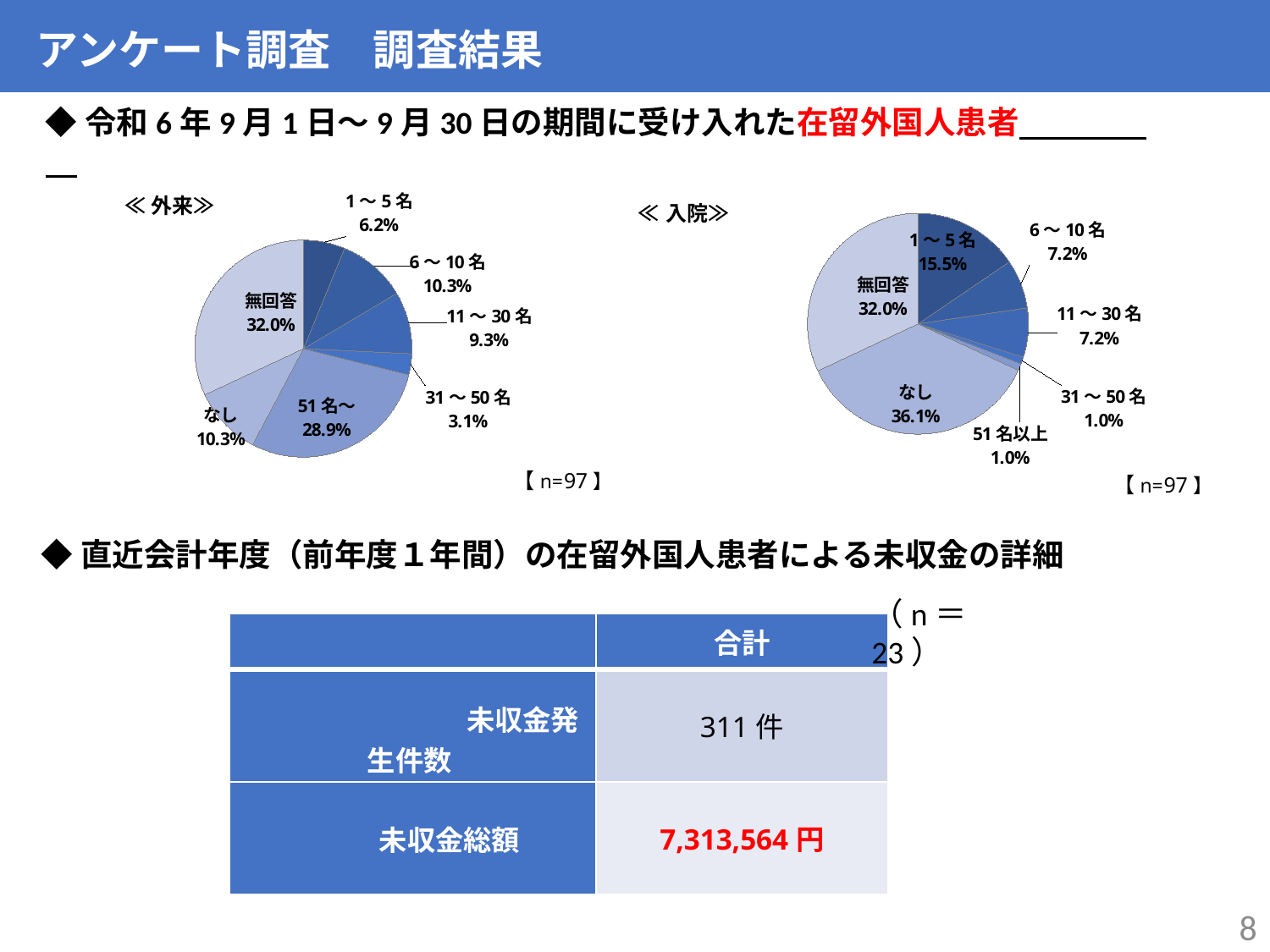
What kind of chart is the ≪外来≫ chart? pie chart In the ≪外来≫ chart, which category has the smallest share? 31～50名 In the ≪外来≫ chart, which category has the largest share? 無回答 In the ≪入院≫ chart, what is the difference between the shares for なし and 無回答? 4.1% In the ≪外来≫ chart, what is the difference between the shares for 6～10名 and 1～5名? 4.1% In the ≪入院≫ chart, which is larger, the share for 1～5名 or the share for 6～10名? 1～5名 In the ≪入院≫ chart, what is the share for 1～5名? 15.5% In the ≪外来≫ chart, what is the share for 無回答? 32.0% In the ≪入院≫ chart, which category has the largest share? なし In the ≪入院≫ chart, what is the share for なし? 36.1% How many categories are shown in the ≪外来≫ chart? 7 In the ≪外来≫ chart, what is the share for 51名～? 28.9%